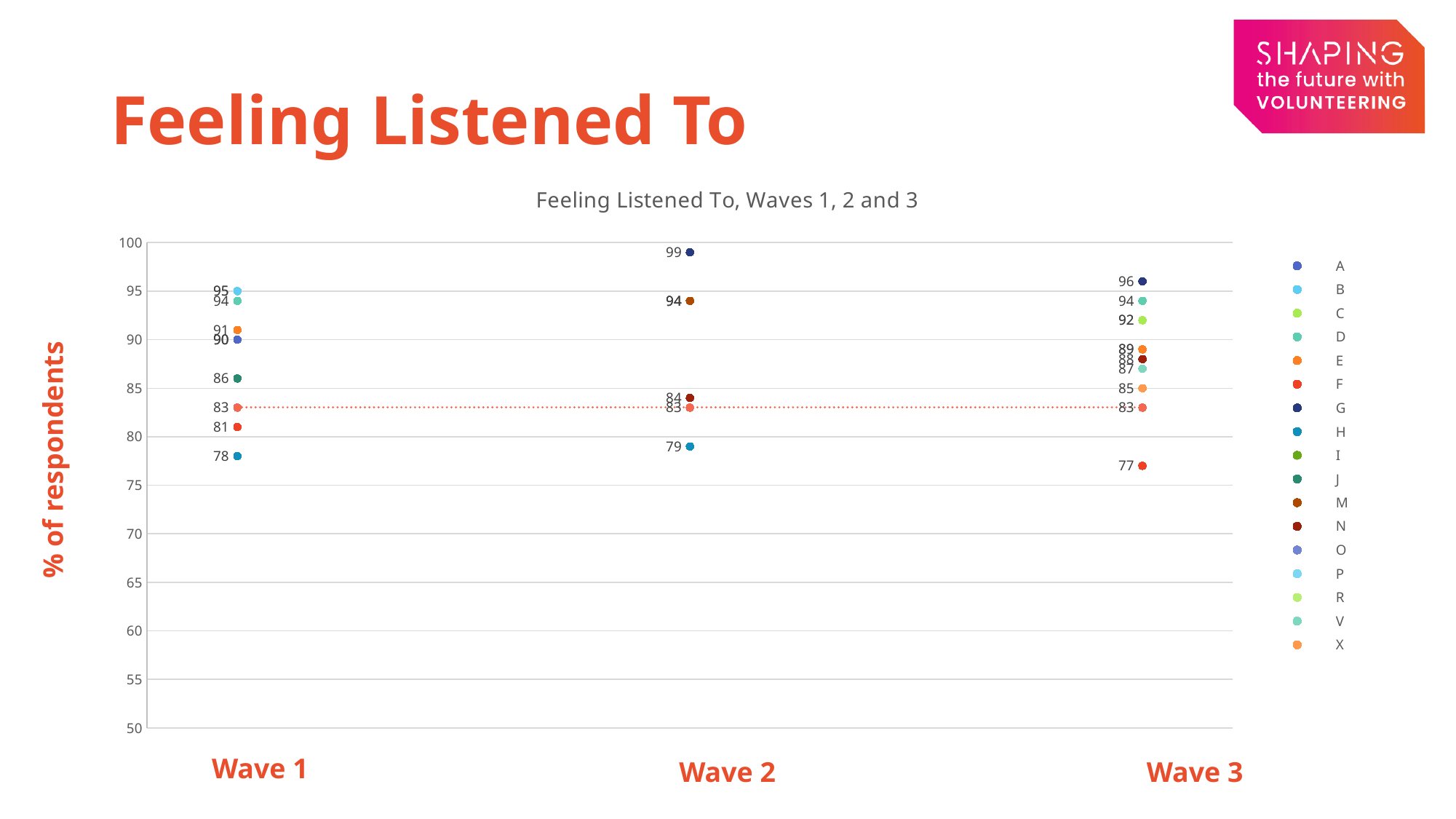
What is the difference between the highest and lowest values plotted in Wave 1? 17 What is the lowest value plotted in Wave 3? 77 What is the highest value plotted in Wave 1? 95 What is the label on the vertical axis of the chart? % of respondents What is the title of the chart? Feeling Listened To, Waves 1, 2 and 3 What is the highest value plotted in Wave 3? 96 What is the highest value plotted in Wave 2? 99 What is the lowest value plotted in Wave 1? 78 What is the difference between the highest and lowest values plotted in Wave 2? 20 How many series does the legend list? 17